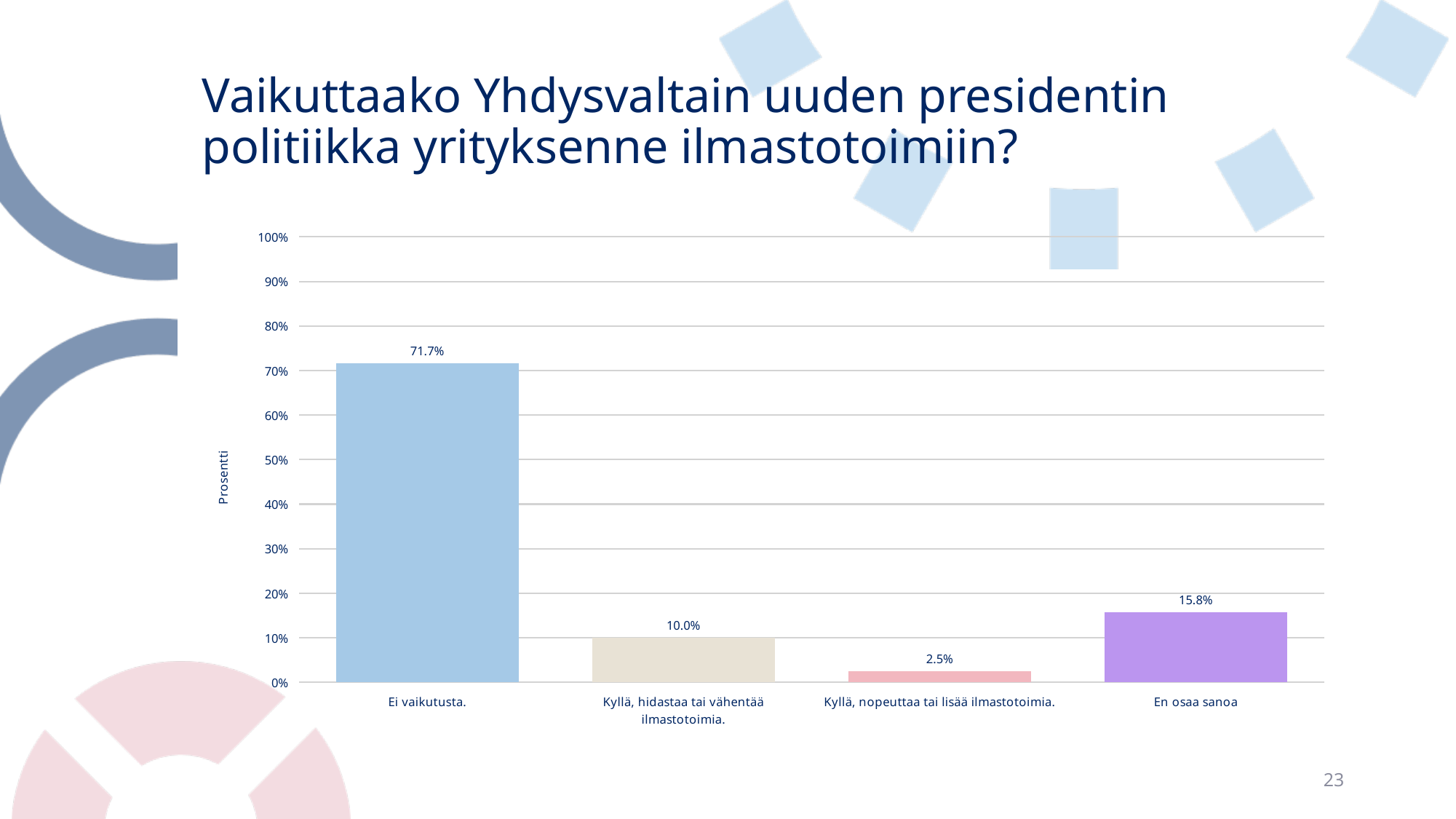
What is the value for "Kyllä, hidastaa tai vähentää ilmastotoimia."? 10.0% Is the value for "Ei vaikutusta." greater or less than 70%? greater How many categories are shown on the x axis? 4 Which is larger: the value for "En osaa sanoa" or the value for "Kyllä, hidastaa tai vähentää ilmastotoimia."? En osaa sanoa What is the value for "Ei vaikutusta."? 71.7% What is the value for "En osaa sanoa"? 15.8% Which category has the highest value? Ei vaikutusta. What is the value for "Kyllä, nopeuttaa tai lisää ilmastotoimia."? 2.5% What is the difference between the values for "Ei vaikutusta." and "En osaa sanoa"? 55.9% What is the label of the y axis? Prosentti What kind of chart is shown on the slide? bar chart Which category has the lowest value? Kyllä, nopeuttaa tai lisää ilmastotoimia.